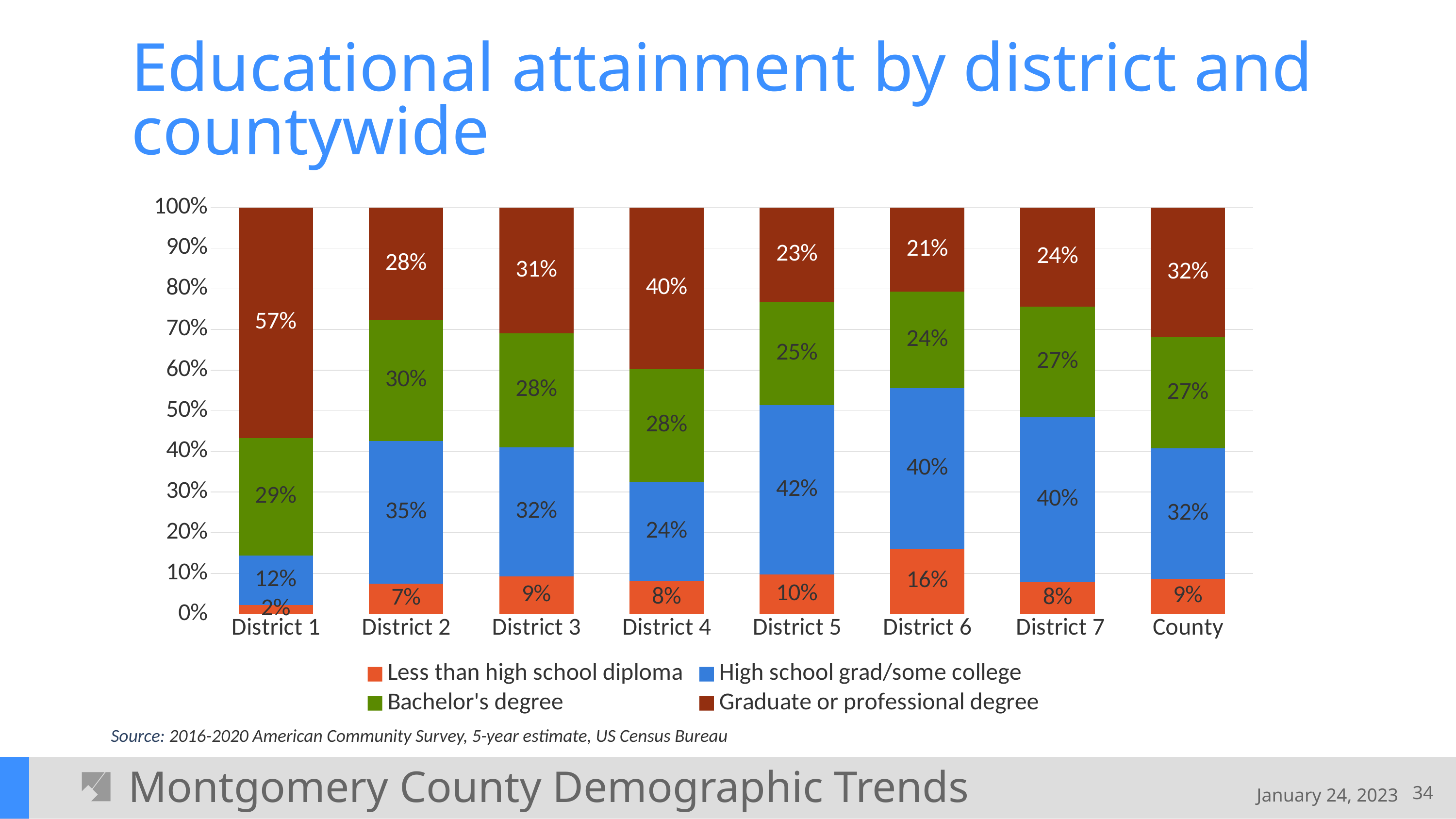
How many series does the legend list? 4 Which district has the lowest share of residents with a graduate or professional degree? District 6 What percentage of District 1 residents have a graduate or professional degree? 57% What is the difference between the 'High school grad/some college' share in District 5 and in District 1? 30% How many categories are shown on the x axis? 8 What kind of chart is shown on the slide? Stacked bar chart What is the title of the chart on the slide? Educational attainment by district and countywide What is the countywide share of residents with a bachelor's degree? 27% What is the value for 'Less than high school diploma' in District 6? 16% Which district has the highest share of residents with less than a high school diploma? District 6 Which is larger: the bachelor's degree share in District 2 or in District 4? District 2 Which series is shown in orange in the legend? Less than high school diploma